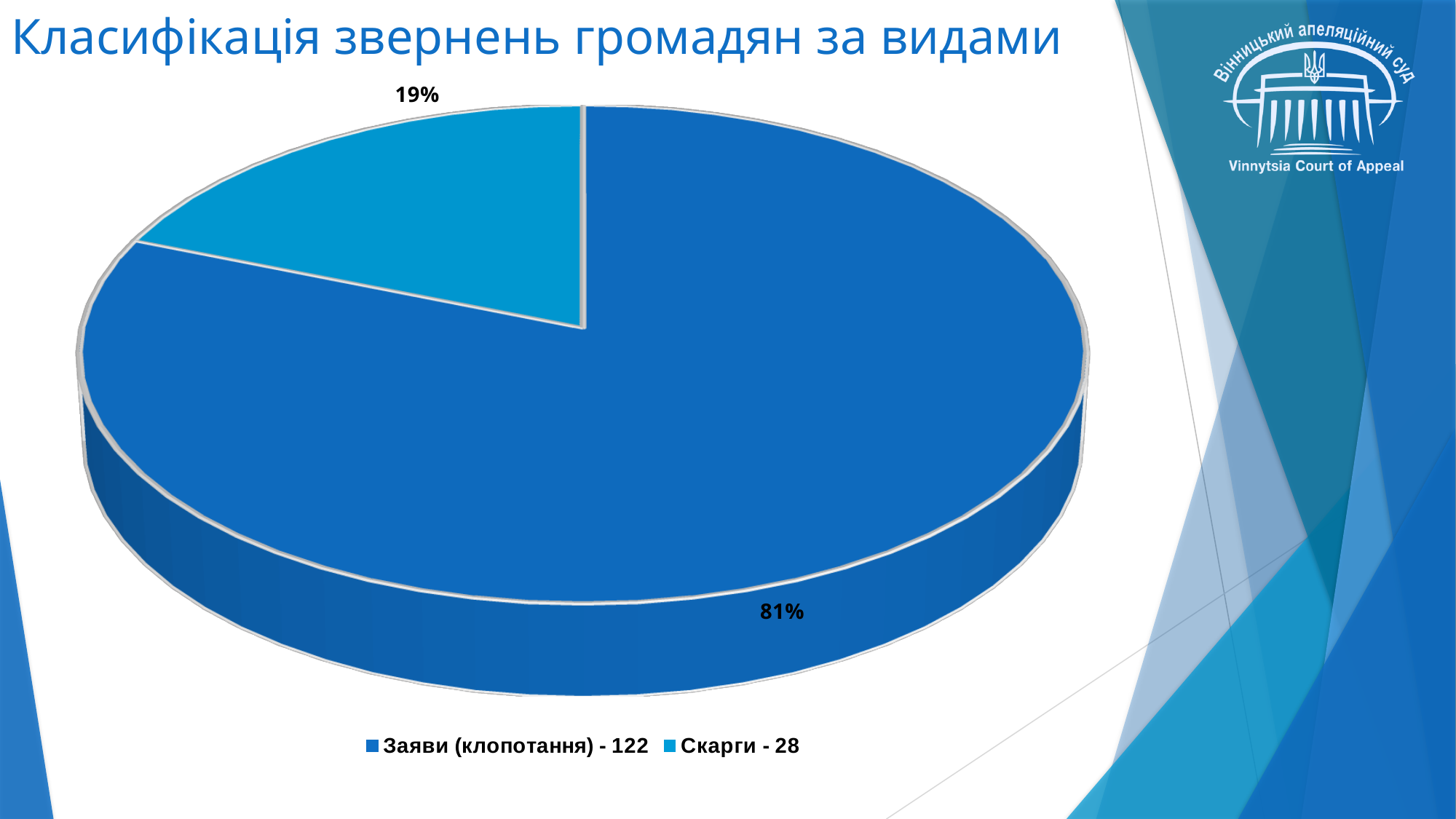
How many slices does the pie chart have? 2 What kind of chart is shown on the slide? Pie chart What is the title of the chart on the slide? Класифікація звернень громадян за видами What percentage share does the "Заяви (клопотання) - 122" slice have? 81% What is the difference in percentage points between the "Заяви (клопотання)" slice and the "Скарги" slice? 62 percentage points What count is shown in the legend for "Заяви (клопотання)"? 122 Which is larger, the share for "Заяви (клопотання)" or the share for "Скарги"? Заяви (клопотання) Which category has the smallest share of the pie? Скарги - 28 What percentage share does the "Скарги - 28" slice have? 19% How many entries does the legend list? 2 What count is shown in the legend for "Скарги"? 28 Which category has the largest share of the pie? Заяви (клопотання) - 122